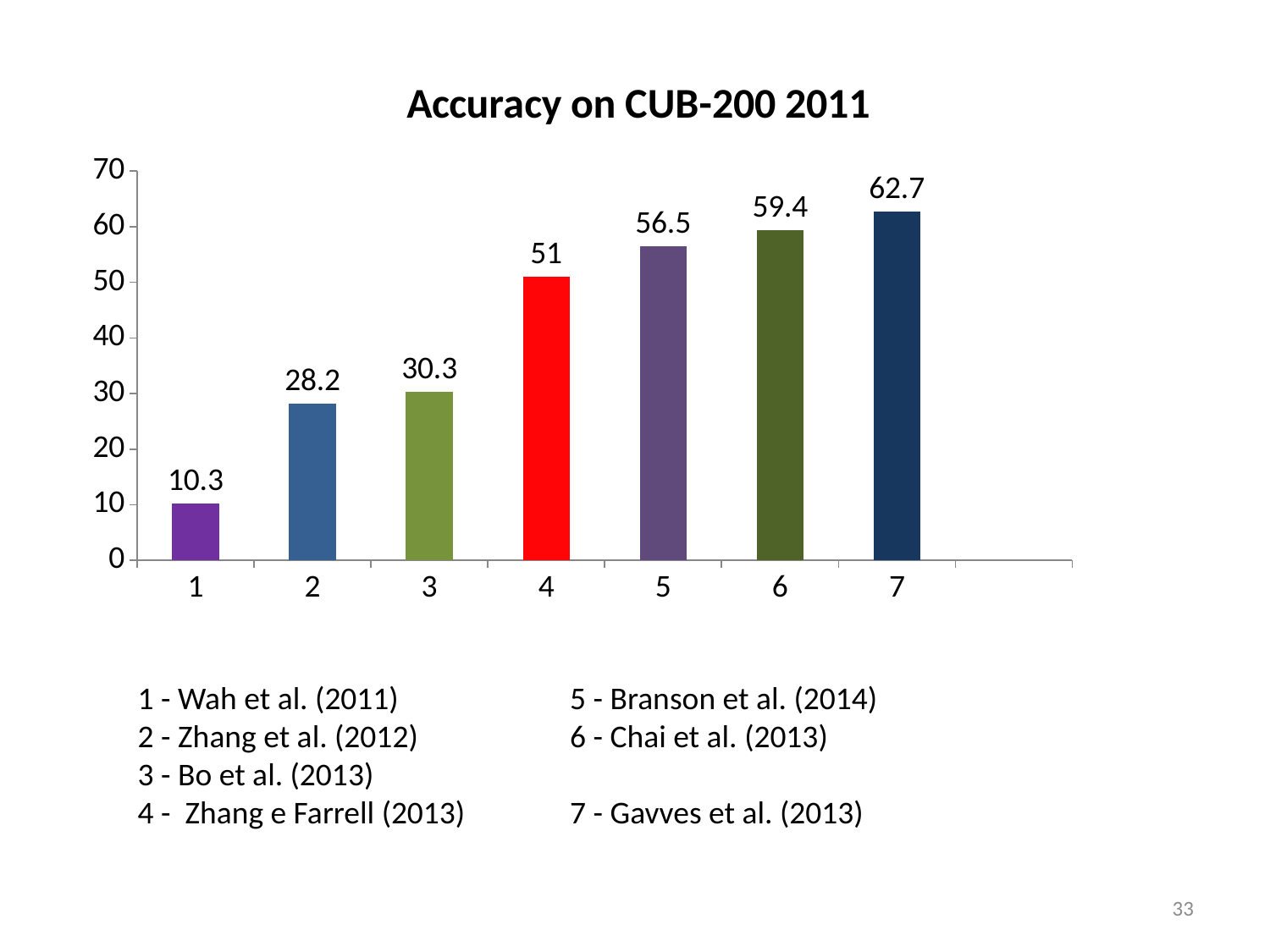
What is the difference between the values for category 7 and category 5? 6.2 What is the difference between the values for category 3 and category 2? 2.1 Is the value for category 5 greater or less than 50? greater How many bars are shown in the chart? 7 What is the accuracy value for category 1? 10.3 What is the title of the chart? Accuracy on CUB-200 2011 What is the accuracy value for category 6? 59.4 Which is larger, the value for category 2 or the value for category 3? 3 Which category has the highest accuracy? 7 What is the accuracy value for category 4? 51 What kind of chart is shown on the slide? bar chart Which category has the lowest accuracy? 1